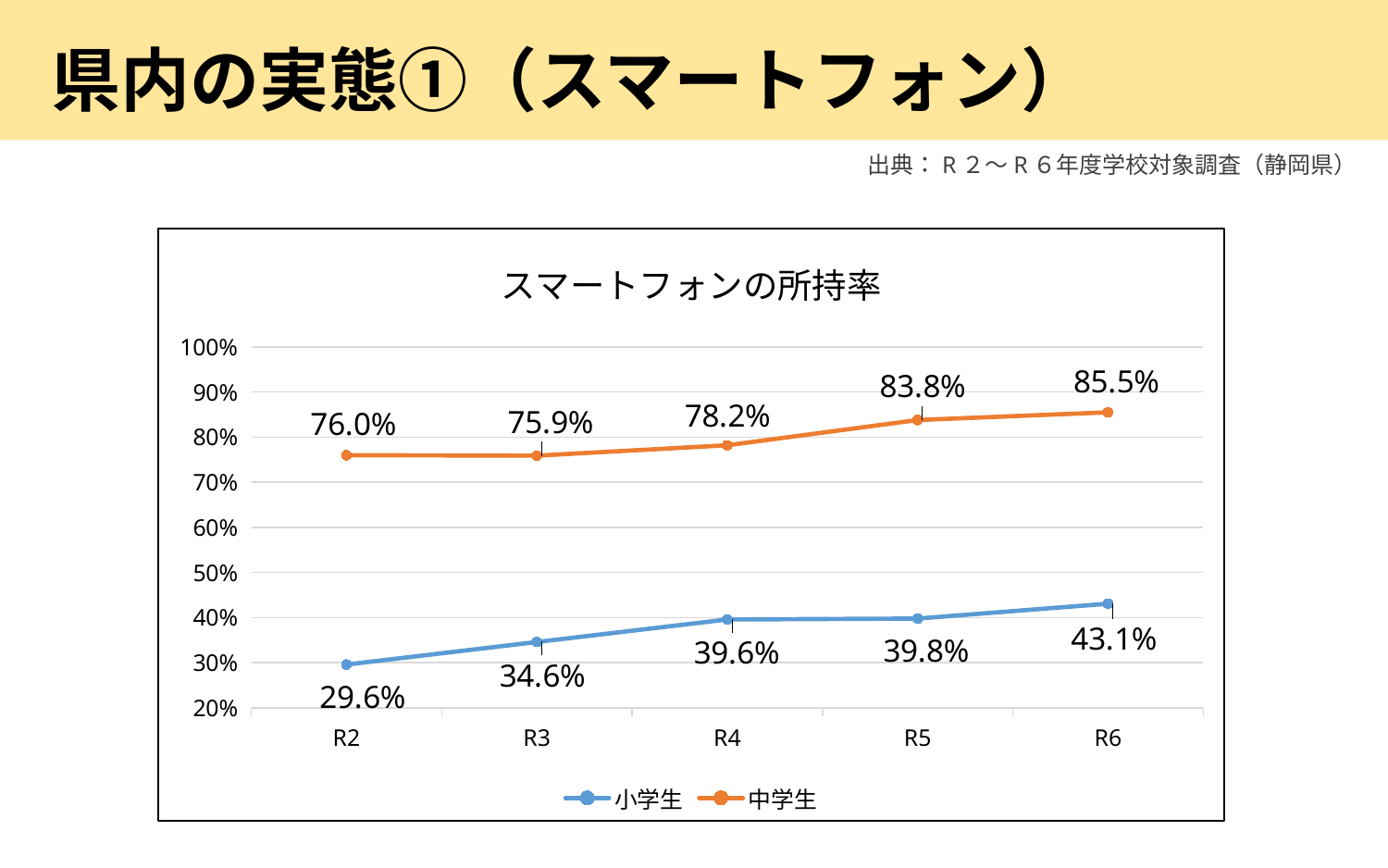
What is the value for 小学生 in R2? 29.6% Does the 小学生 series rise or fall from R2 to R6? rise How many years are shown on the x axis? 5 In which year is the 小学生 value lowest? R2 How many series does the legend list? 2 Is the 中学生 value in R5 greater or less than 80%? greater What is the value for 小学生 in R6? 43.1% In which year is the 中学生 value highest? R6 What is the value for 中学生 in R4? 78.2% What kind of chart is this? line chart Which is larger, the 小学生 value in R4 or in R3? R4 What is the difference between the 中学生 and 小学生 values in R6? 42.4%